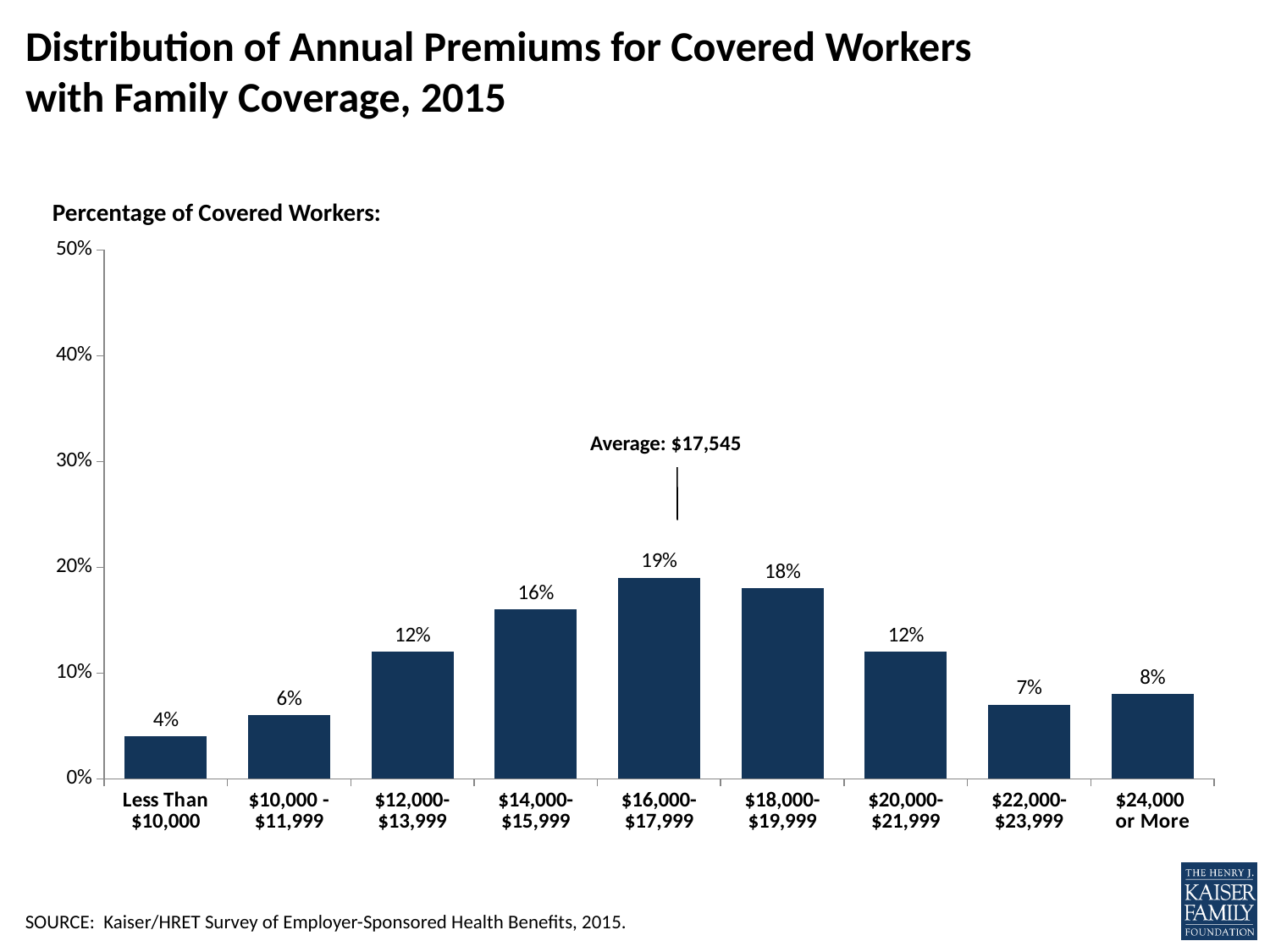
Which has a larger share of covered workers: the $18,000-$19,999 range or the $20,000-$21,999 range? $18,000-$19,999 Which premium range has the lowest percentage of covered workers? Less Than $10,000 What is the total percentage of covered workers in the $12,000-$13,999 and $20,000-$21,999 ranges combined? 24% What percentage of covered workers have annual family premiums of $24,000 or more? 8% What kind of chart is shown on the slide? Bar chart What is the difference in percentage points between the $14,000-$15,999 range and the $10,000-$11,999 range? 10 percentage points What is the average annual premium noted on the chart? $17,545 What percentage of covered workers have annual family premiums of less than $10,000? 4% Is the value for the $22,000-$23,999 range greater or less than 10%? less How many premium ranges are shown on the chart? 9 What percentage of covered workers have annual family premiums of $16,000-$17,999? 19% Which premium range has the highest percentage of covered workers? $16,000-$17,999